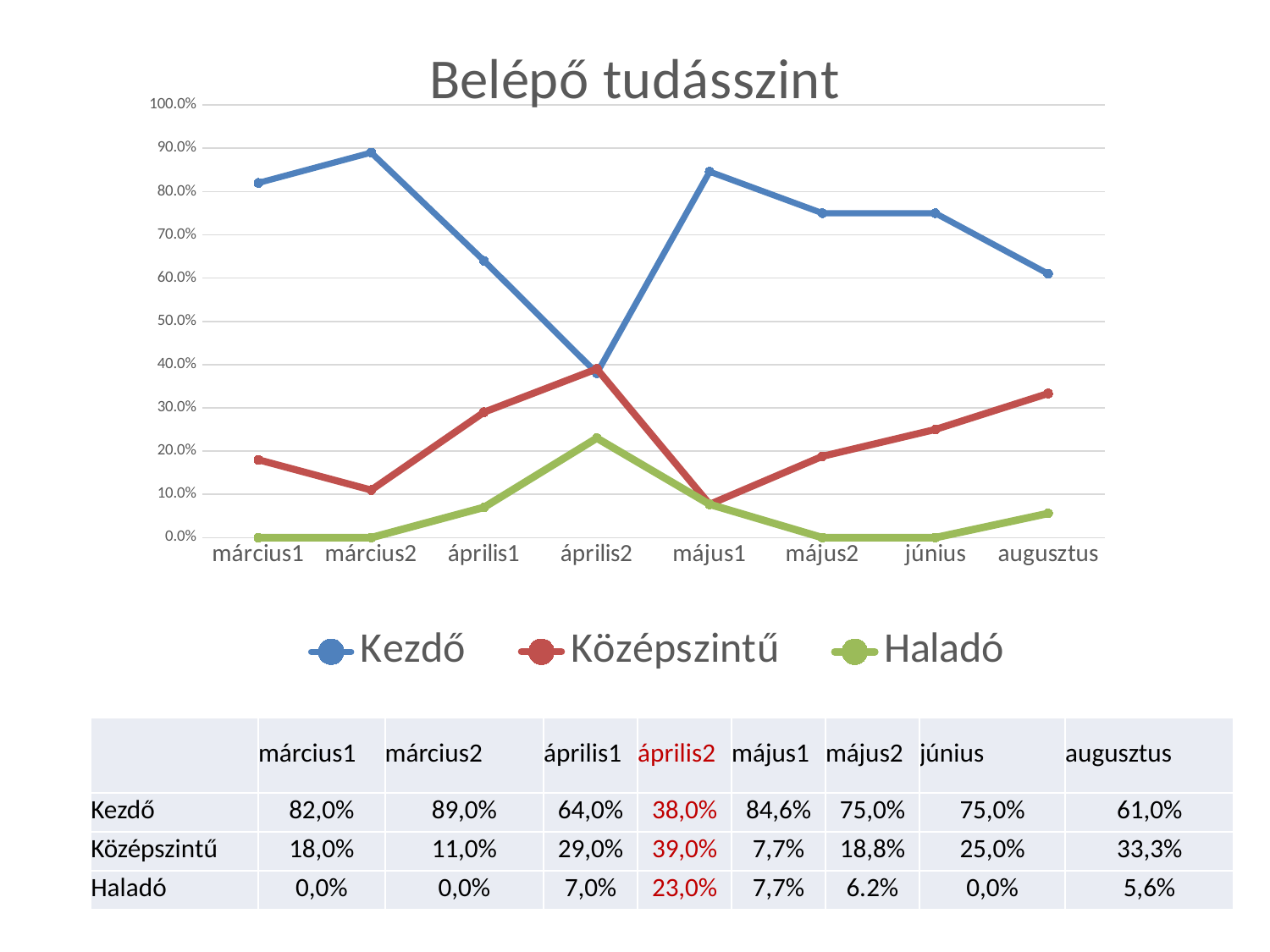
What is the value for Középszintű at április2? 39,0% How many series does the legend list? 3 What is the value for Haladó at augusztus? 5,6% At which category is the Kezdő series lowest? április2 What kind of chart is shown on the slide? line chart What is the title of the chart? Belépő tudásszint At május1, which series has the larger value, Kezdő or Középszintű? Kezdő At which category is the Kezdő series highest? március2 What is the value for Kezdő at március2? 89,0% How many categories are plotted along the x axis? 8 What is the difference between the Kezdő values at március2 and április2? 51,0% Is the value for Kezdő at augusztus greater or less than 50%? greater